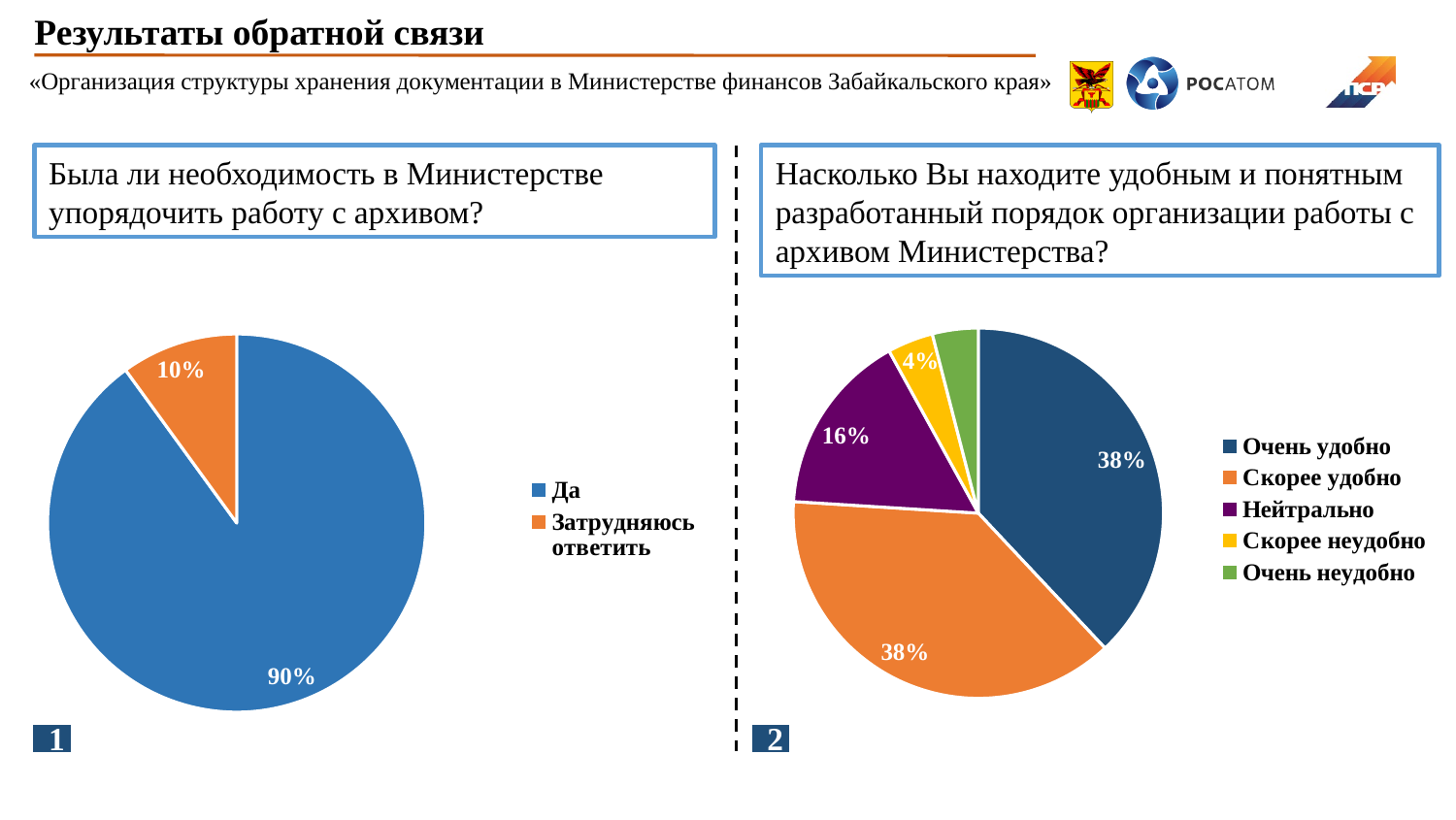
In the left chart, which category has the largest slice? Да How many categories does the legend of the left chart list? 2 In the right chart, what share of respondents answered "Нейтрально"? 16% What type of chart is the left chart on the slide? pie chart How many categories does the legend of the right chart list? 5 In the right chart, what share of respondents answered "Скорее неудобно"? 4% In the right chart, what colour is the slice for "Скорее удобно"? orange In the right chart, which is larger: the slice for "Нейтрально" or the slice for "Скорее неудобно"? Нейтрально In the left chart, what share of respondents answered "Да"? 90% In the right chart, what share of respondents answered "Очень удобно"? 38% In the left chart, what share of respondents answered "Затрудняюсь ответить"? 10% In the left chart, what is the difference in percentage points between "Да" and "Затрудняюсь ответить"? 80